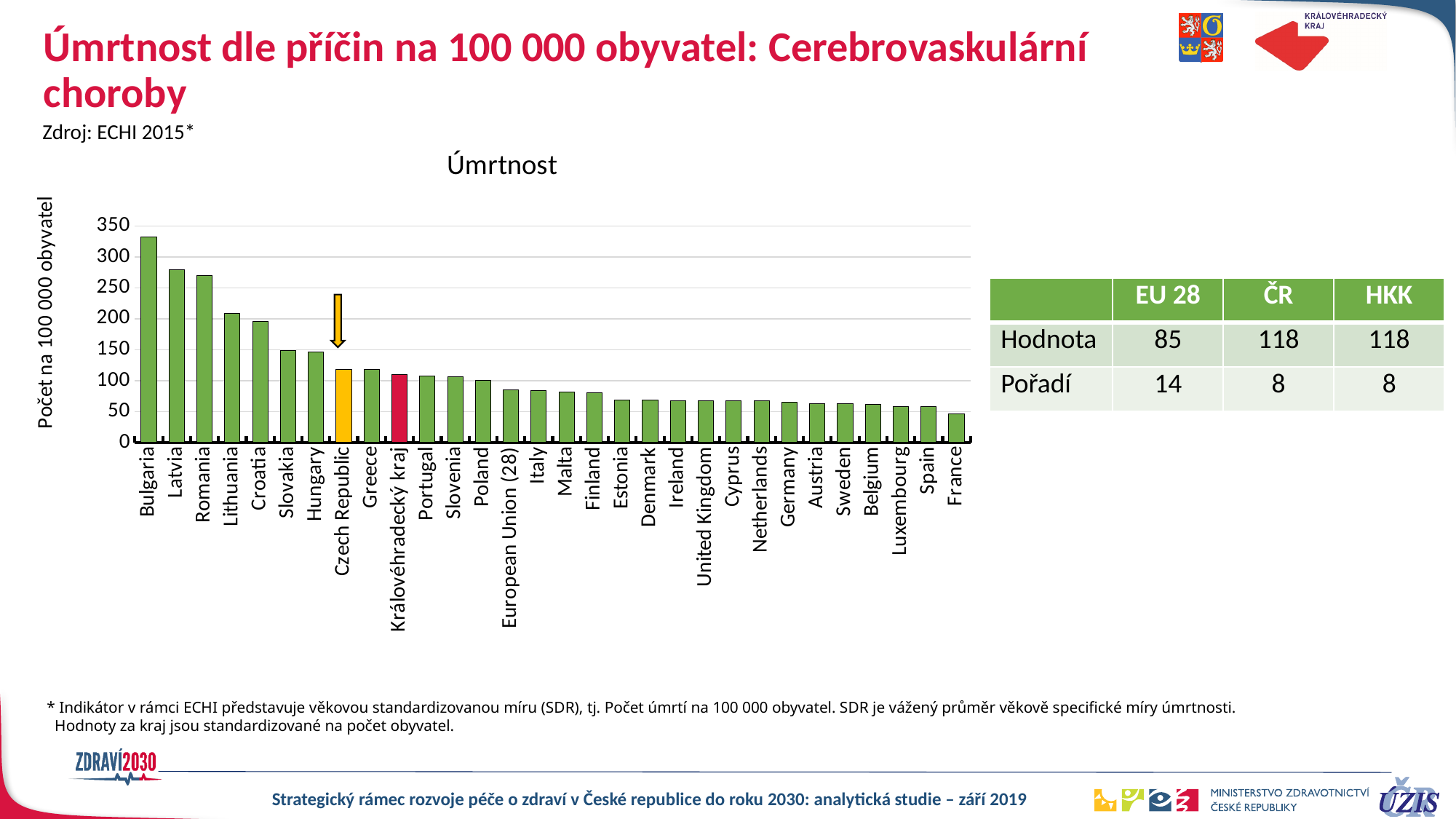
Do the values rise or fall moving from left to right along the x axis? fall What colour is the bar for Czech Republic? yellow Which category has the highest value in the chart? Bulgaria Is the value for Italy greater or less than 100? less Is the value for Bulgaria greater or less than 300? greater Which is larger, the value for Bulgaria or the value for Latvia? Bulgaria What kind of chart is shown on the slide? bar chart Is the value for Lithuania greater or less than 200? greater According to the table next to the chart, what is the value (Hodnota) for EU 28? 85 Which category has the lowest value in the chart? France How many categories (bars) are plotted in the chart? 30